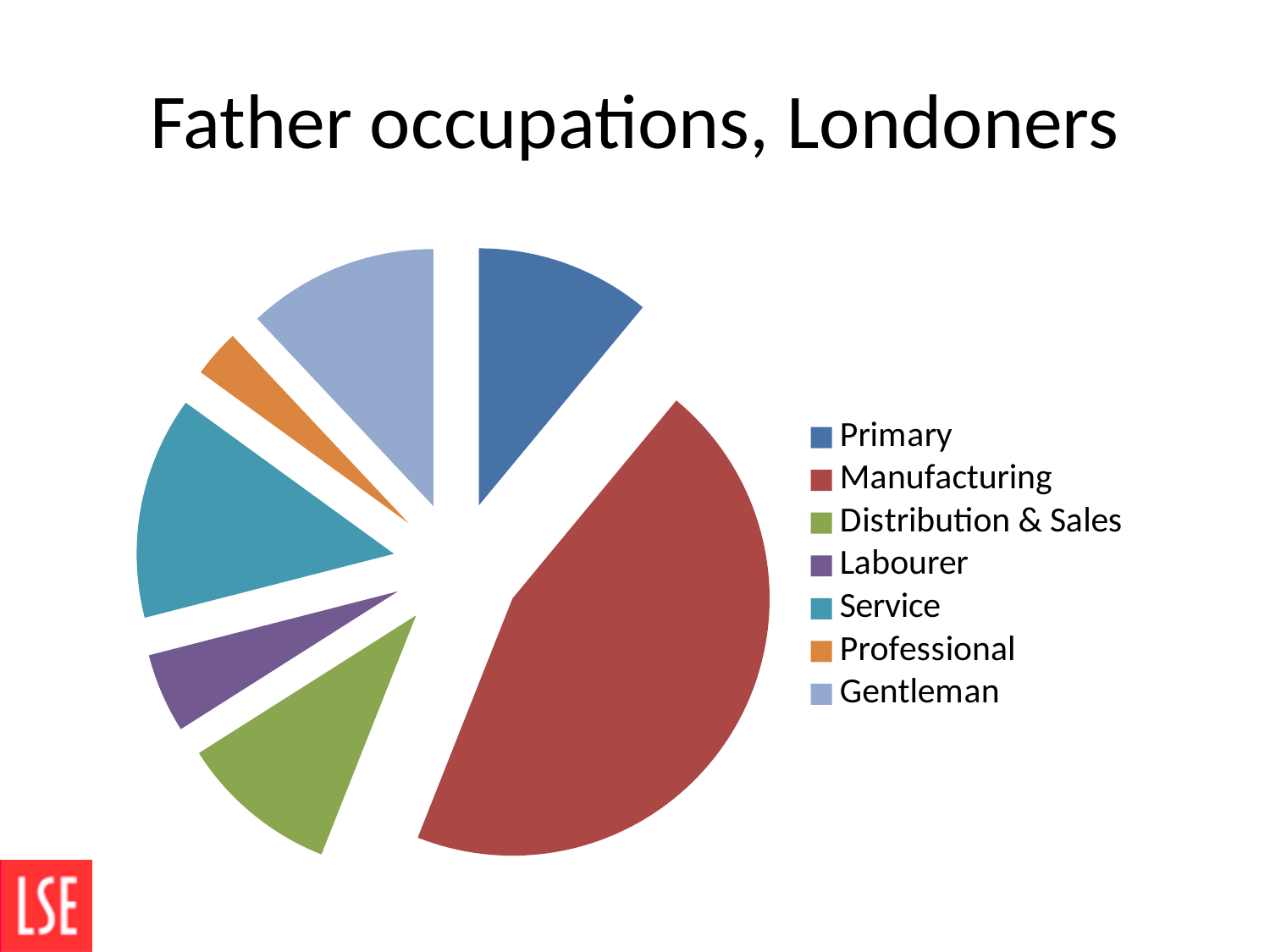
How many entries does the legend list? 7 How many categories (slices) does the pie chart have? 7 What colour is the Manufacturing slice? red Which slice is larger, Distribution & Sales or Labourer? Distribution & Sales Which slice is larger, Manufacturing or Primary? Manufacturing Which category has the smallest slice of the pie? Professional Which category has the largest slice of the pie? Manufacturing What is the title of the chart? Father occupations, Londoners Which slice is larger, Gentleman or Professional? Gentleman What kind of chart is shown on the slide? pie chart